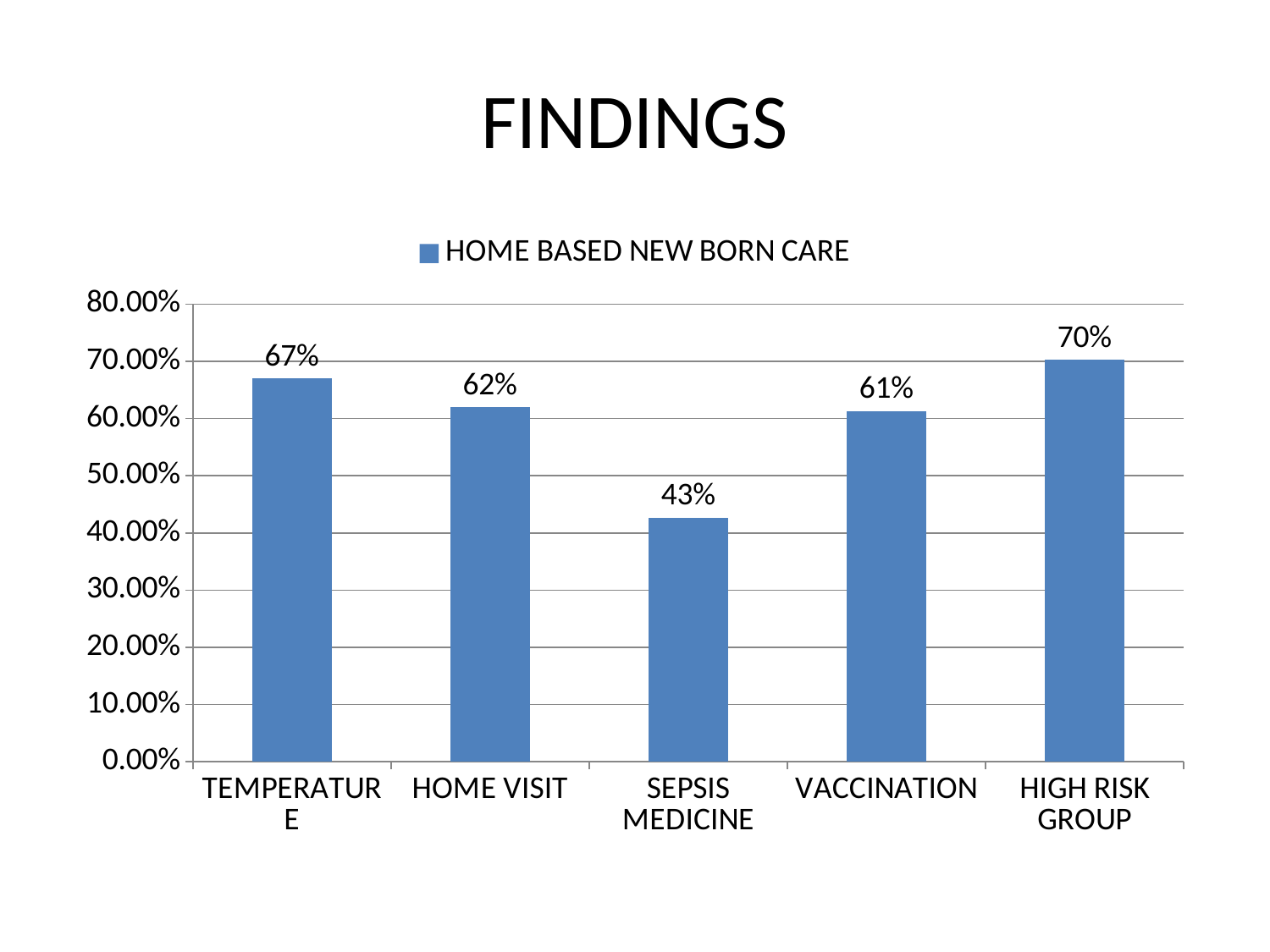
Which is larger, the value for HOME VISIT or the value for TEMPERATURE? TEMPERATURE What kind of chart is shown on the slide? bar chart What is the value for HIGH RISK GROUP? 70% What is the value for TEMPERATURE? 67% How many categories are shown on the x axis? 5 Is the value for SEPSIS MEDICINE greater or less than 50.00%? less What is the value for VACCINATION? 61% Which category has the highest value? HIGH RISK GROUP What series name does the legend show? HOME BASED NEW BORN CARE What is the value for SEPSIS MEDICINE? 43% Which category has the lowest value? SEPSIS MEDICINE What is the difference between the values for HIGH RISK GROUP and SEPSIS MEDICINE? 27%